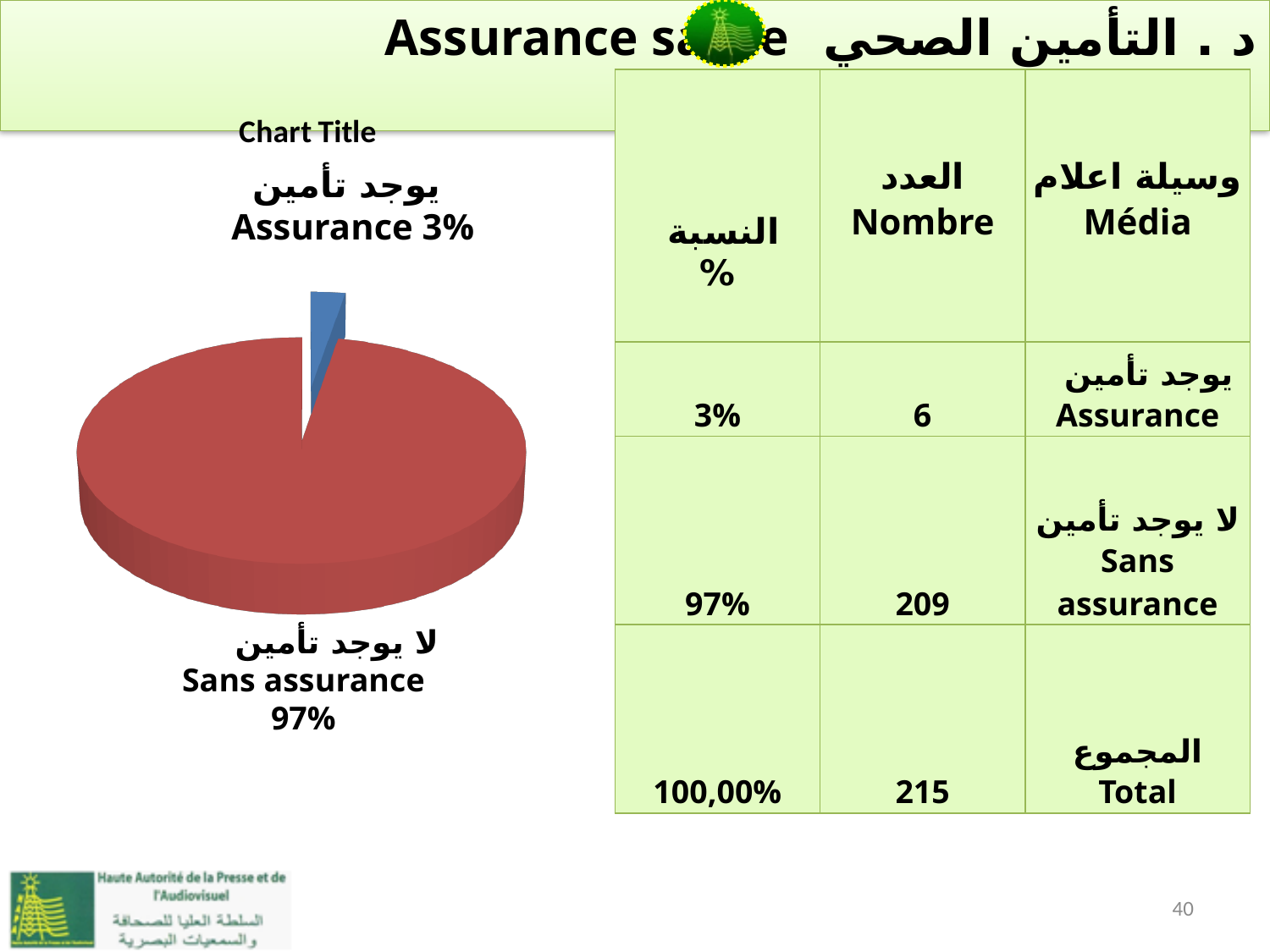
By how many percentage points does the "Sans assurance" slice exceed the "Assurance" slice? 94 percentage points What share of the pie does the "Sans assurance" slice represent? 97% What is the title printed above the pie chart? Chart Title What kind of chart is shown on the slide? Pie chart Which is larger in the pie chart: the "Assurance" slice or the "Sans assurance" slice? Sans assurance How many slices does the pie chart have? 2 Which slice of the pie chart is the largest? Sans assurance Which slice of the pie chart is the smallest? Assurance What colour is the "Sans assurance" slice of the pie chart? Red What percentage of the pie chart is labelled "Sans assurance" (لا يوجد تأمين)? 97% What percentage of the pie chart is labelled "Assurance" (يوجد تأمين)? 3%